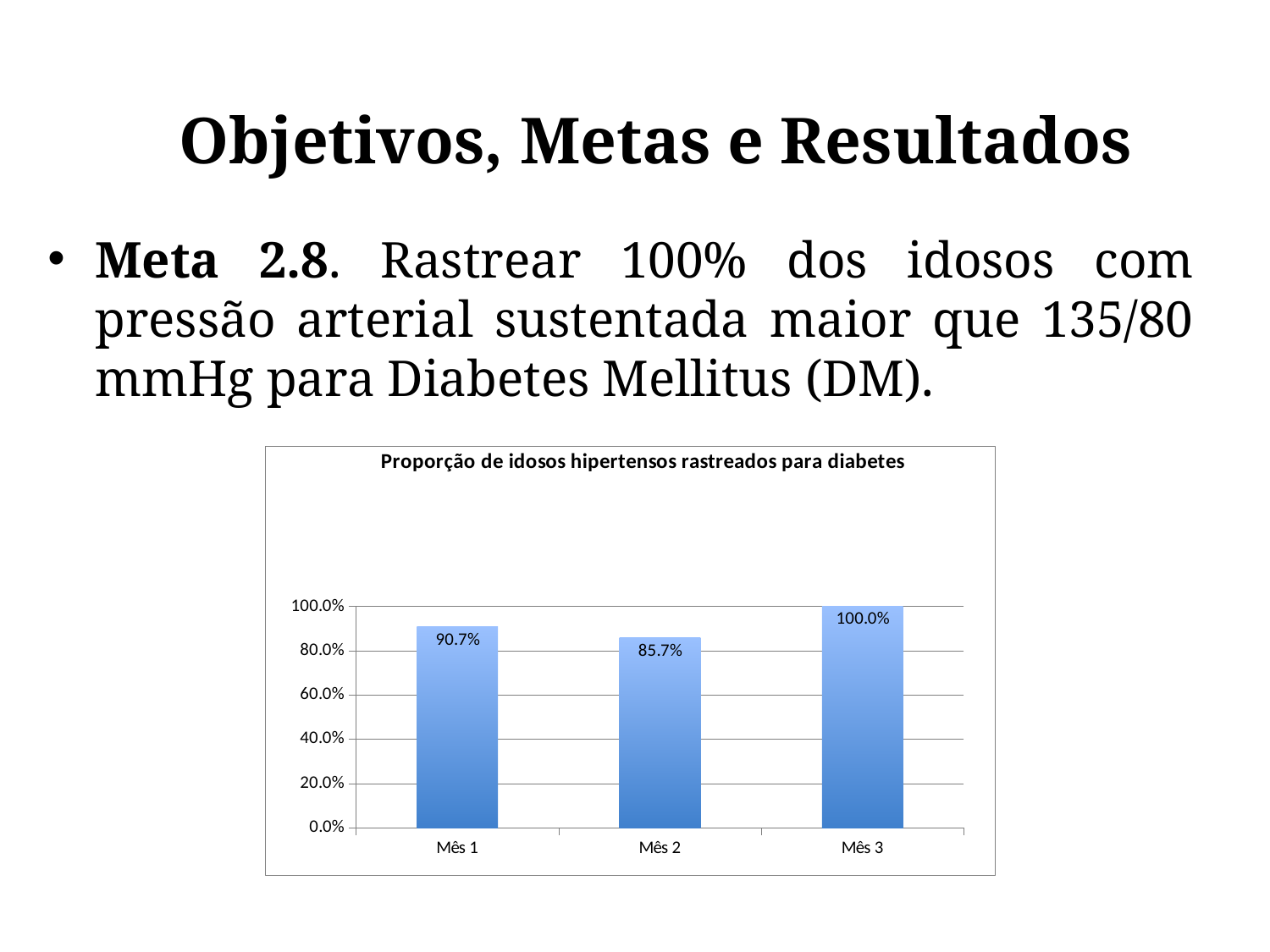
What is the value for Mês 2? 85.7% What is the difference between the values for Mês 3 and Mês 2? 14.3% What is the title of the chart? Proporção de idosos hipertensos rastreados para diabetes What is the value for Mês 1? 90.7% What is the value for Mês 3? 100.0% How many months are shown on the chart? 3 What is the difference between the values for Mês 1 and Mês 2? 5.0% Which month has the lowest proportion? Mês 2 Is the value for Mês 2 greater or less than 80.0%? greater What kind of chart is shown on the slide? bar chart Which is larger, the value for Mês 1 or the value for Mês 2? Mês 1 Which month has the highest proportion? Mês 3